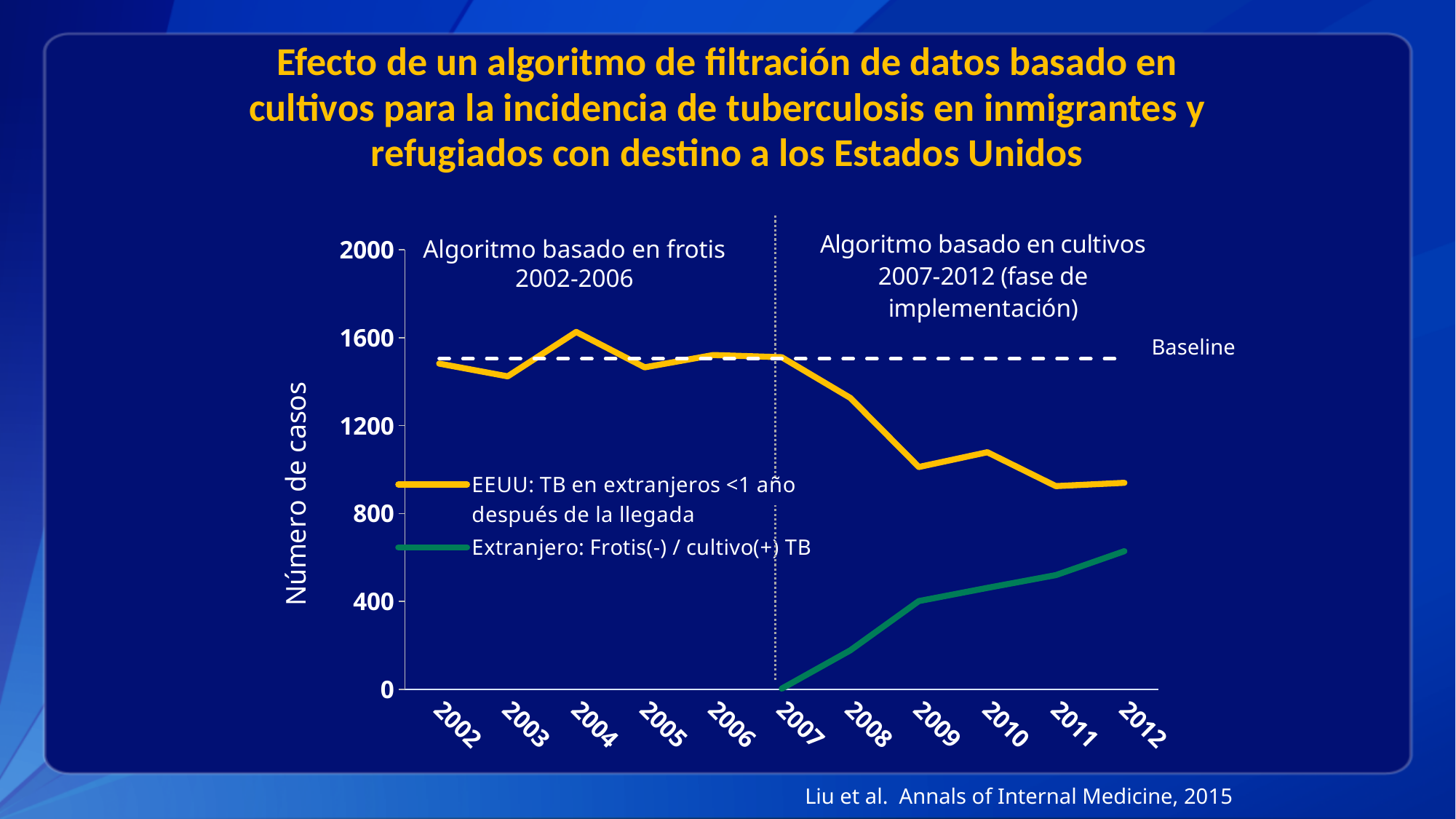
How many years are shown along the x axis? 11 In which year does the series 'EEUU: TB en extranjeros <1 año después de la llegada' reach its highest value? 2004 How many series does the legend list? 2 What is the label of the y axis? Número de casos Does the series 'Extranjero: Frotis(-) / cultivo(+) TB' rise or fall from 2007 to 2012? rise Is the value for 'EEUU: TB en extranjeros <1 año después de la llegada' in 2009 greater or less than 1200? less Is the value for 'Extranjero: Frotis(-) / cultivo(+) TB' in 2012 greater or less than 400? greater Which is larger for 'EEUU: TB en extranjeros <1 año después de la llegada': the value in 2003 or the value in 2004? 2004 In which year does the series 'Extranjero: Frotis(-) / cultivo(+) TB' reach its highest value? 2012 What kind of chart is shown on the slide? line chart